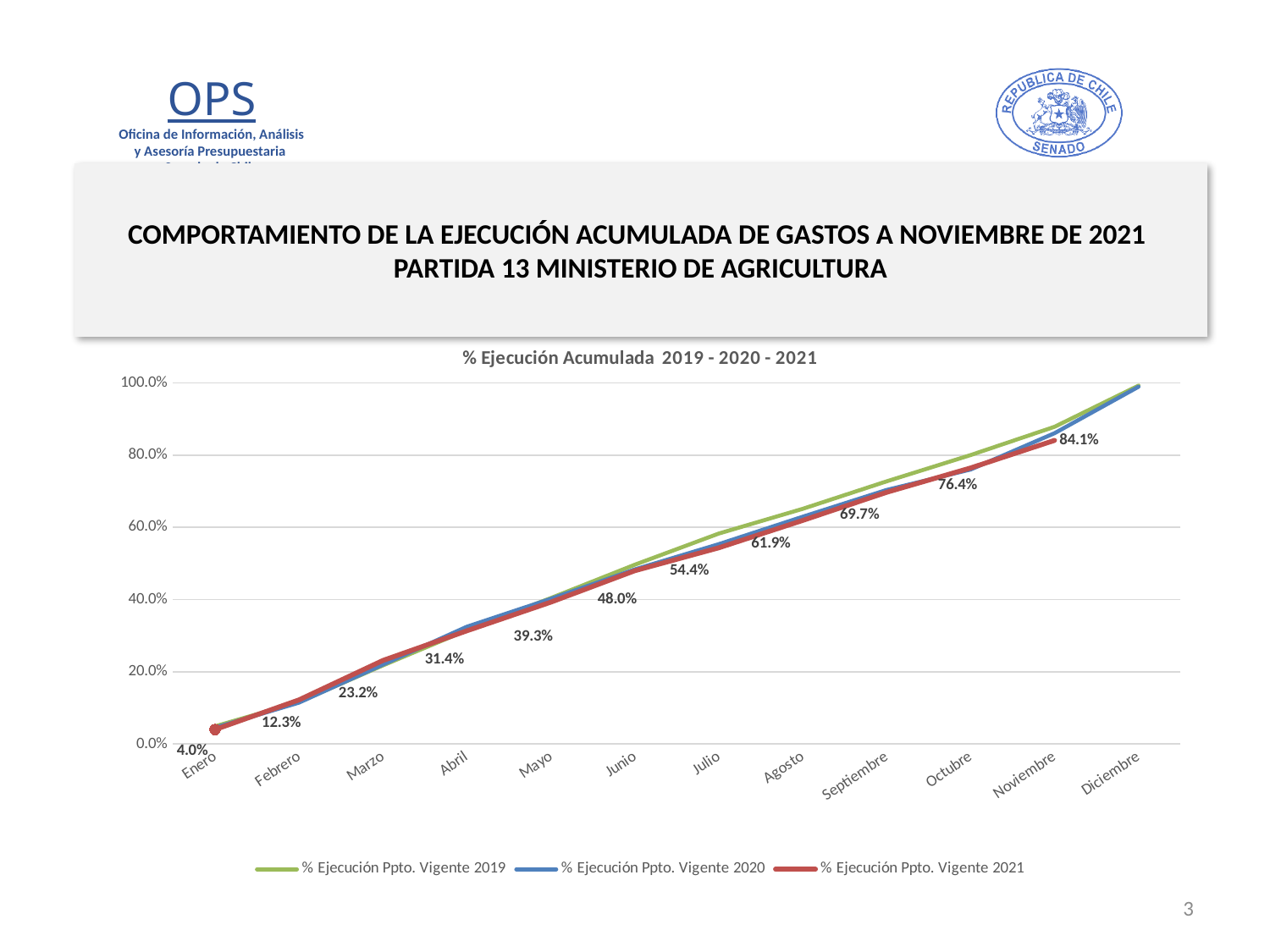
Is the value of % Ejecución Ppto. Vigente 2019 for Diciembre greater or less than 80.0%? greater What is the value of % Ejecución Ppto. Vigente 2021 for Enero? 4.0% Do the % Ejecución Ppto. Vigente 2021 values rise or fall from Enero to Noviembre? rise What is the difference between the % Ejecución Ppto. Vigente 2021 values for Noviembre and Octubre? 7.7% How many months are shown on the x axis? 12 What is the chart's title? % Ejecución Acumulada 2019 - 2020 - 2021 What is the value of % Ejecución Ppto. Vigente 2021 for Noviembre? 84.1% What is the value of % Ejecución Ppto. Vigente 2021 for Junio? 48.0% What is the value of % Ejecución Ppto. Vigente 2021 for Septiembre? 69.7% How many series does the legend list? 3 What kind of chart is shown on the slide? line chart Which month has the lowest value for % Ejecución Ppto. Vigente 2021? Enero